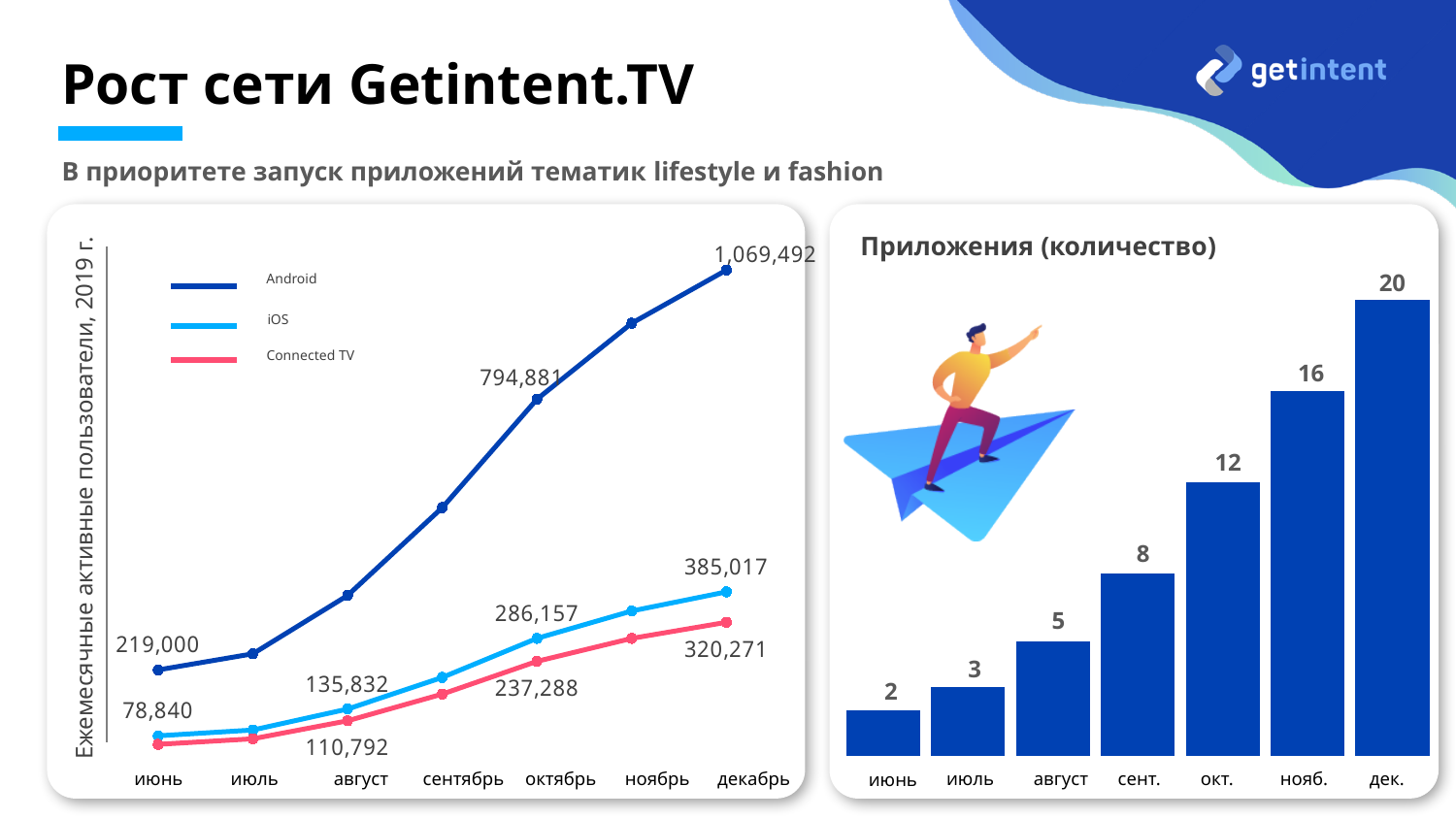
On the right chart 'Приложения (количество)', which month has the lowest value? июнь On the right chart 'Приложения (количество)', do the values rise or fall from июнь to дек.? rise On the left line chart, which series is higher in декабрь, iOS or Connected TV? iOS On the left line chart, what is the Connected TV value for октябрь? 237,288 On the left line chart, how many series does the legend list? 3 On the right chart 'Приложения (количество)', what is the difference between the values for дек. and нояб.? 4 On the left line chart, what is the Android value for декабрь? 1,069,492 On the right chart 'Приложения (количество)', what is the value for сент.? 8 On the right chart 'Приложения (количество)', how many bars are shown? 7 What kind of chart is the right chart 'Приложения (количество)'? bar chart On the left line chart, what is the iOS value for июнь? 78,840 On the right chart 'Приложения (количество)', what is the value for дек.? 20